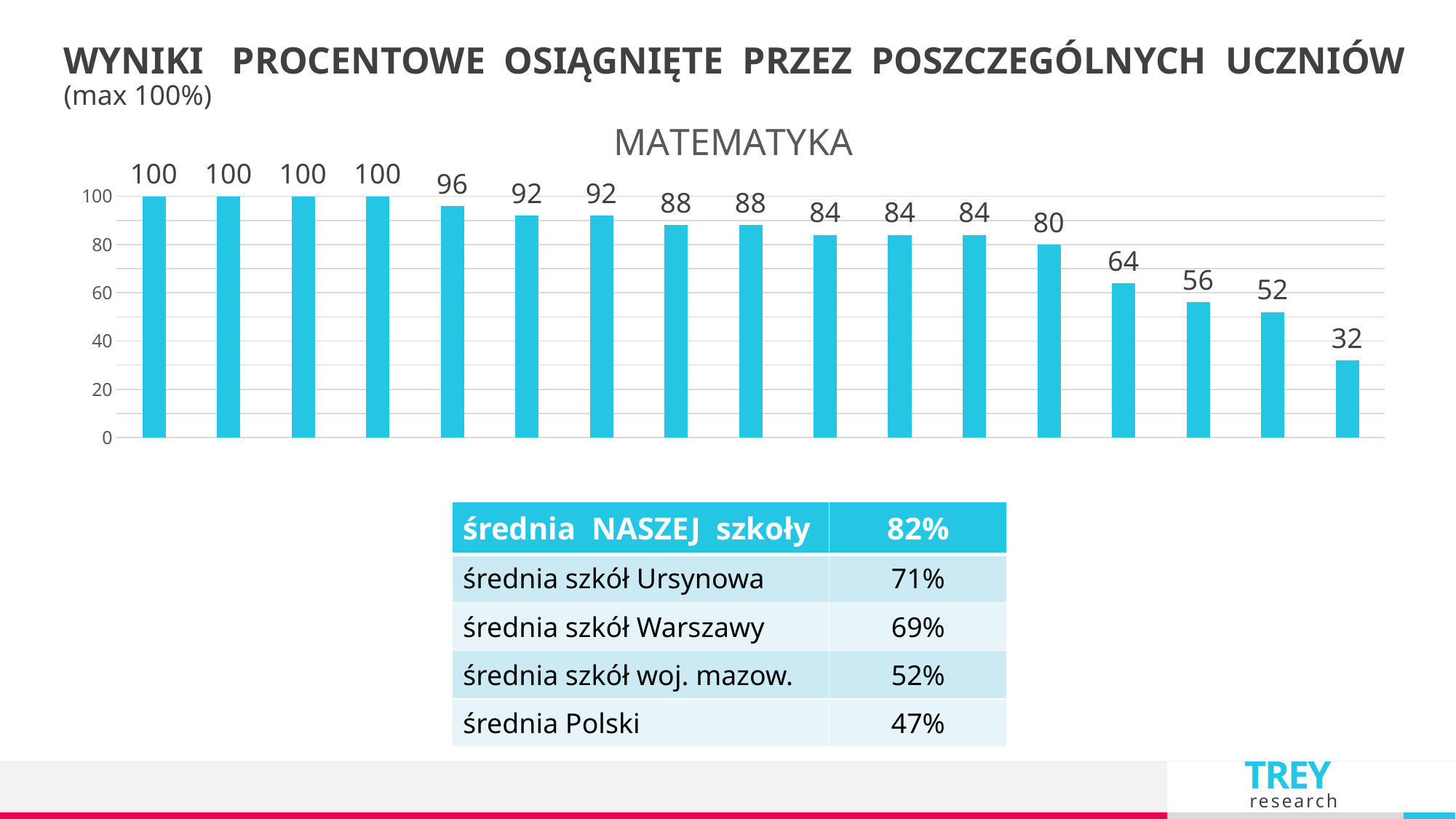
What is the title of the chart? MATEMATYKA What kind of chart is shown on the slide? bar chart What is the difference between the highest bar value and the lowest bar value in the chart? 68 What is the value of the rightmost bar in the chart? 32 What is the value of the fifth bar from the left in the chart? 96 What is the highest value shown on any bar in the chart? 100 How many bars in the chart have a value of 100? 4 Do the bar values rise or fall from left to right across the chart? fall How many bars in the chart have a value of 84? 3 Is the value of the rightmost bar greater or less than 40? less How many bars are plotted in the chart? 17 What is the lowest value shown on any bar in the chart? 32